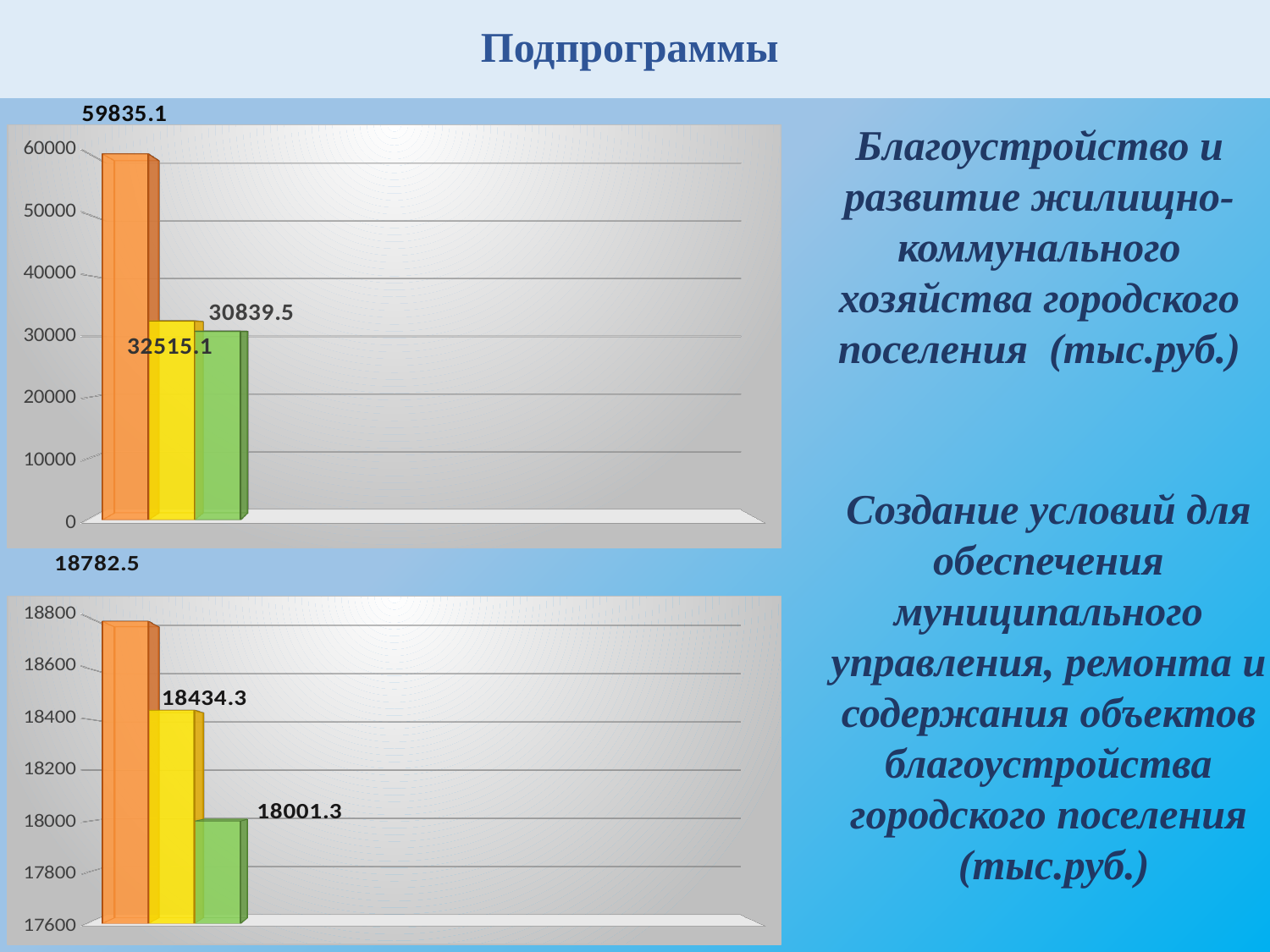
In the top chart, what is the value of the orange (first) bar? 59835.1 In the bottom chart, which bar is the lowest? the green (third) bar, 18001.3 In the bottom chart, what is the difference between the orange bar (18782.5) and the green bar (18001.3)? 781.2 How many bars are plotted in the top chart? 3 What type of chart is the top chart on the slide? bar chart Do the bar values in the bottom chart rise or fall from left to right? fall In the top chart, what is the difference between the orange bar (59835.1) and the yellow bar (32515.1)? 27320 What is the highest tick value shown on the vertical axis of the bottom chart? 18800 In the bottom chart, which is larger: the orange bar or the yellow bar? the orange bar (18782.5) In the top chart, what is the value of the green (third) bar? 30839.5 In the top chart, which bar is the highest? the orange (first) bar, 59835.1 In the bottom chart, what is the value of the yellow (second) bar? 18434.3